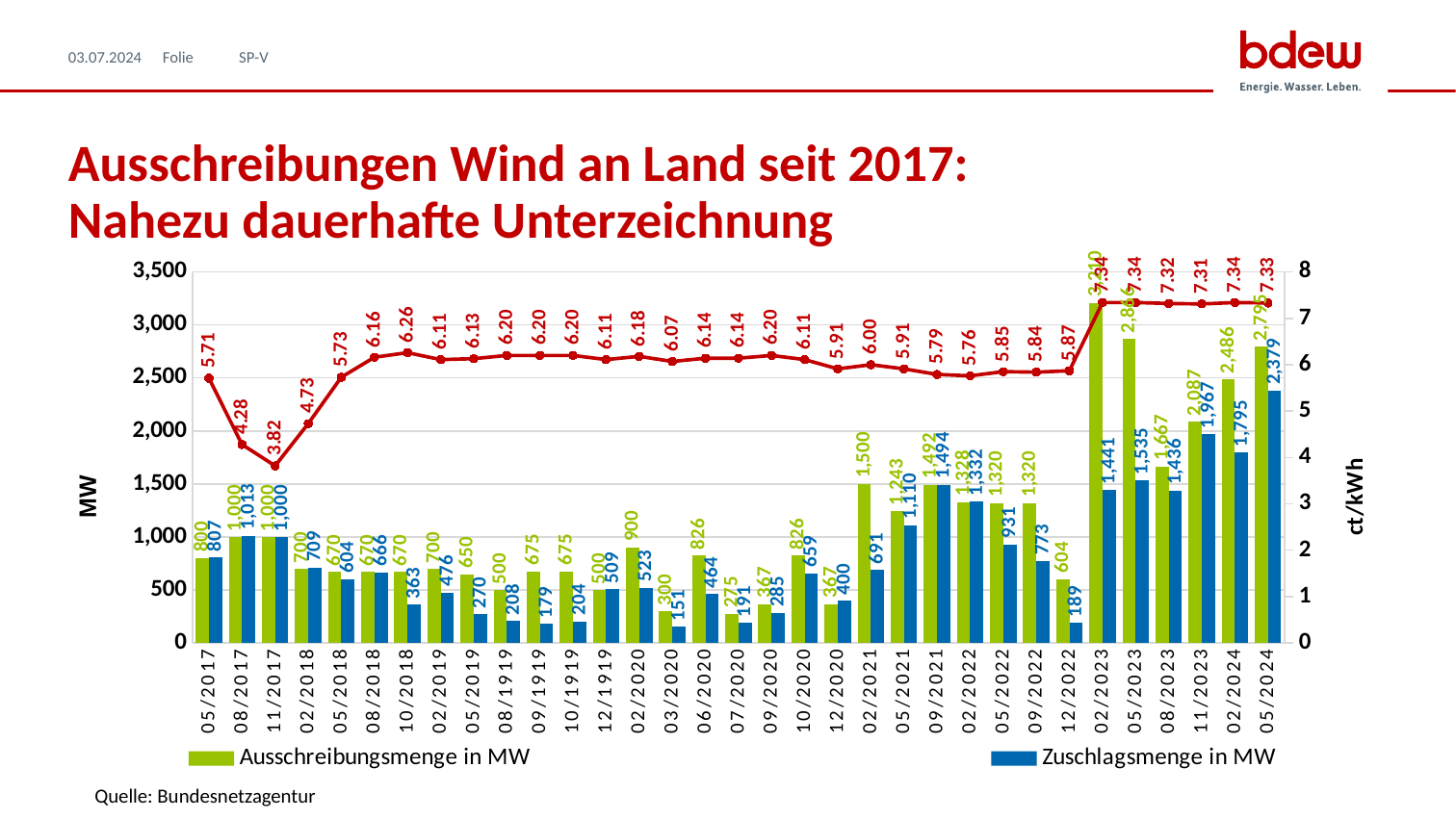
What is the Zuschlagsmenge in MW for 05/2024? 2,379 In which period does the red line reach its lowest value? 11/2017 What unit is shown on the right-hand axis? ct/kWh Is the Zuschlagsmenge for 11/2023 greater or less than 1,500? greater How many periods are shown on the x axis? 33 What value does the red line show for 11/2017? 3.82 What is the difference between the Ausschreibungsmenge and the Zuschlagsmenge in 05/2024? 416 In which period is the Ausschreibungsmenge highest? 02/2023 What is the Ausschreibungsmenge in MW for 02/2021? 1,500 How many series does the legend list? 2 In which period is the Zuschlagsmenge lowest? 03/2020 Which is larger in 05/2022, the Ausschreibungsmenge or the Zuschlagsmenge? Ausschreibungsmenge